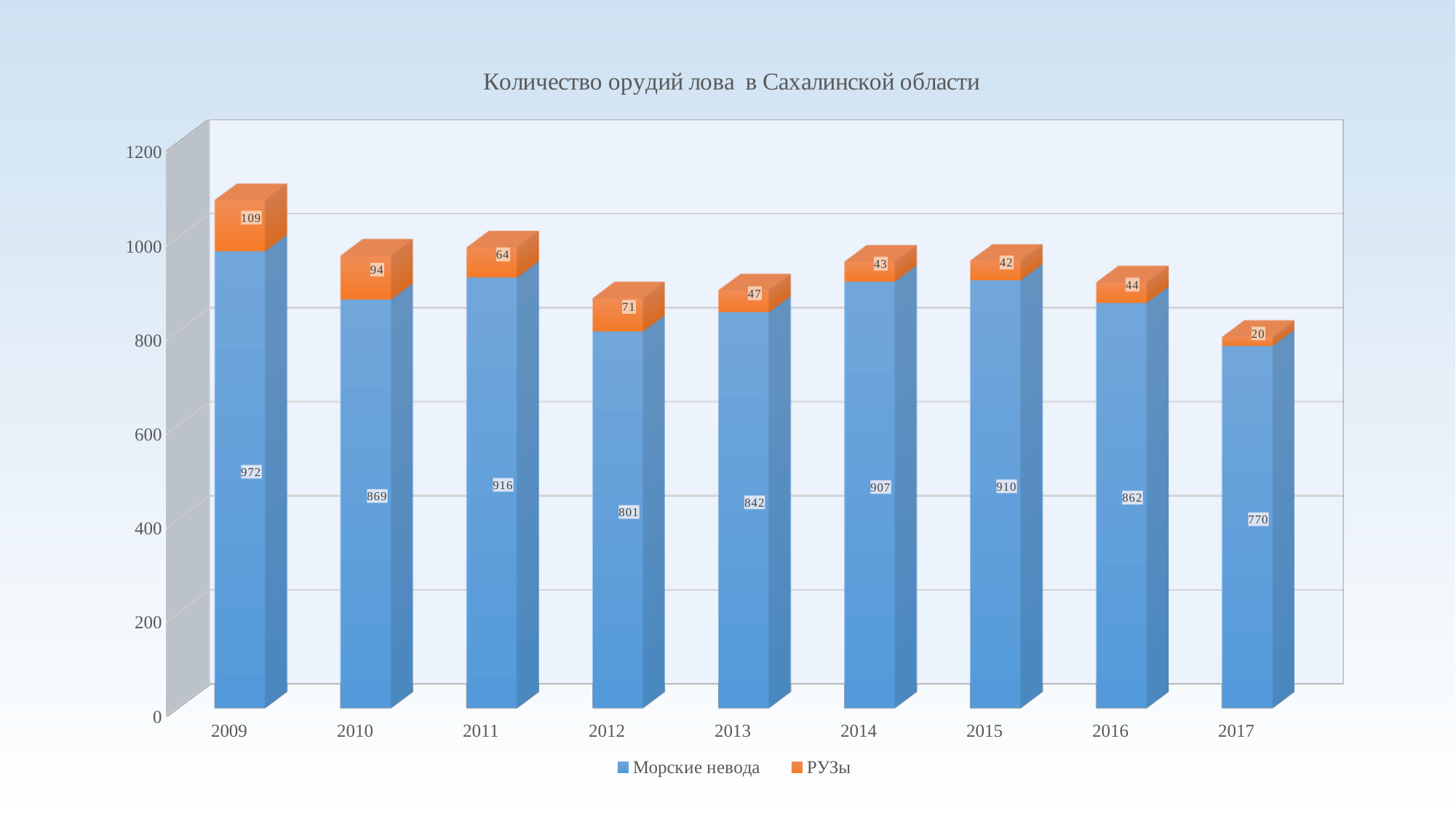
What is the total of the stacked bar for 2009? 1081 What is the difference between the Морские невода values for 2009 and 2017? 202 How many years are shown on the x axis? 9 What is the title of the chart? Количество орудий лова в Сахалинской области What is the total of the stacked bar for 2017? 790 What is the value for РУЗы in 2013? 47 What is the value for Морские невода in 2011? 916 In which year is the value for РУЗы the lowest? 2017 Which is larger, the РУЗы value for 2010 or for 2012? 2010 What type of chart is shown on the slide? Stacked bar chart In which year is the value for Морские невода the highest? 2009 How many series does the legend list? 2